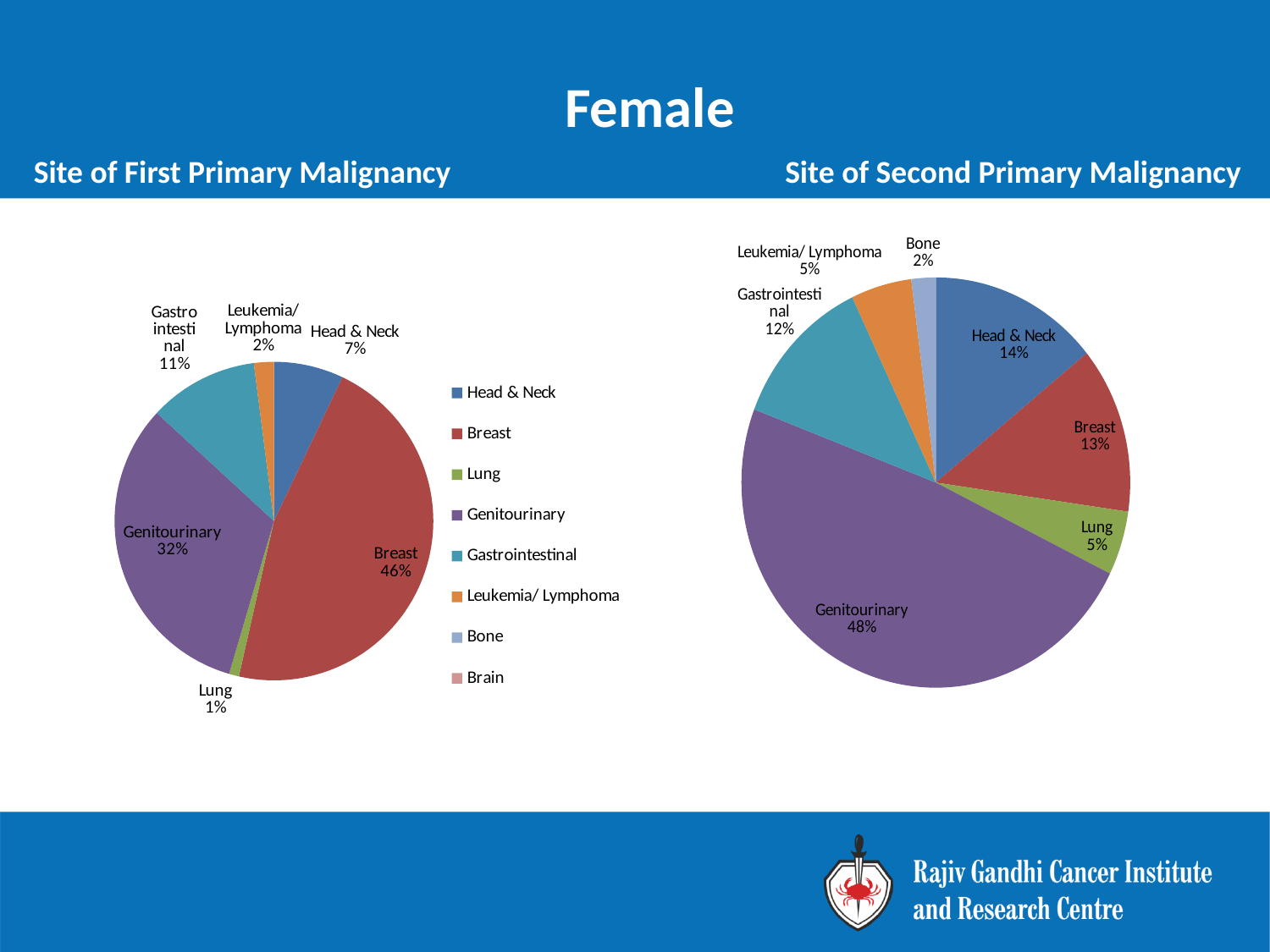
What kind of chart is used for 'Site of First Primary Malignancy'? Pie chart In the 'Site of Second Primary Malignancy' chart, what share does Genitourinary account for? 48% In the 'Site of First Primary Malignancy' chart, what is the difference between the Breast share and the Genitourinary share? 14% How many entries does the legend of the 'Site of First Primary Malignancy' chart list? 8 In the 'Site of First Primary Malignancy' chart, which site has the smallest share? Lung In the 'Site of Second Primary Malignancy' chart, what is the difference between the Head & Neck share and the Breast share? 1% In the 'Site of First Primary Malignancy' chart, what share does Gastrointestinal account for? 11% In the 'Site of First Primary Malignancy' chart, which site has the largest share? Breast How many labelled slices does the 'Site of Second Primary Malignancy' pie chart have? 7 In the 'Site of First Primary Malignancy' chart, what share does Breast account for? 46% Which is larger in the 'Site of Second Primary Malignancy' chart: the Gastrointestinal share or the Lung share? Gastrointestinal In the 'Site of Second Primary Malignancy' chart, which site has the smallest share? Bone